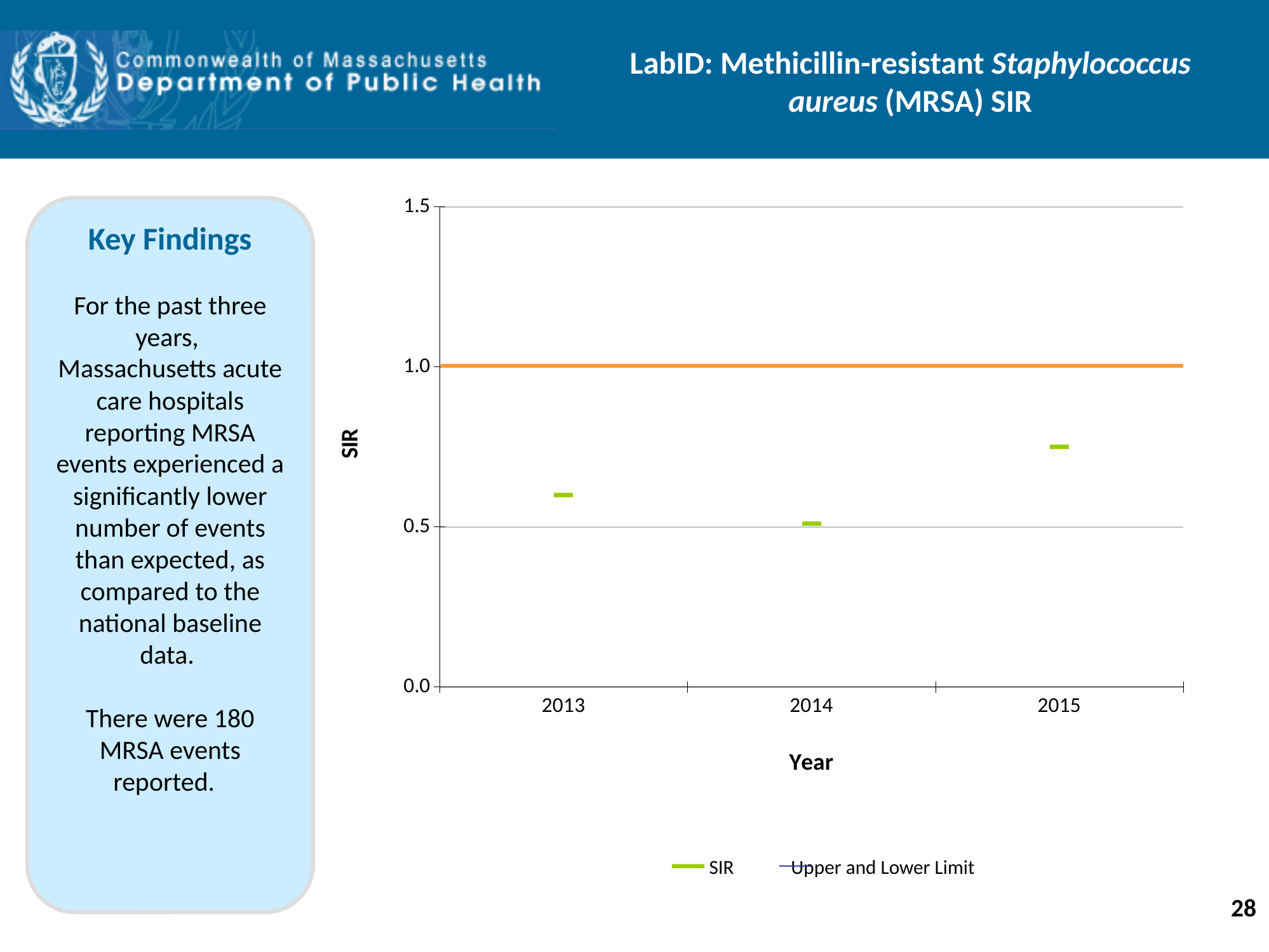
How many series does the chart legend list? 2 How many years are shown on the x axis of the chart? 3 Does the SIR value rise or fall from 2014 to 2015? rise Which year has a larger SIR value, 2013 or 2015? 2015 Which year has the lowest SIR value? 2014 Is the SIR value for 2015 greater or less than 1.0? less Is the SIR value for 2013 greater or less than 1.0? less Which year has the highest SIR value? 2015 What is the title of the x axis of the chart? Year At what value on the SIR axis does the Upper and Lower Limit line sit? 1.0 What type of chart is shown on the slide? line chart Is the SIR value for 2015 greater or less than 0.5? greater